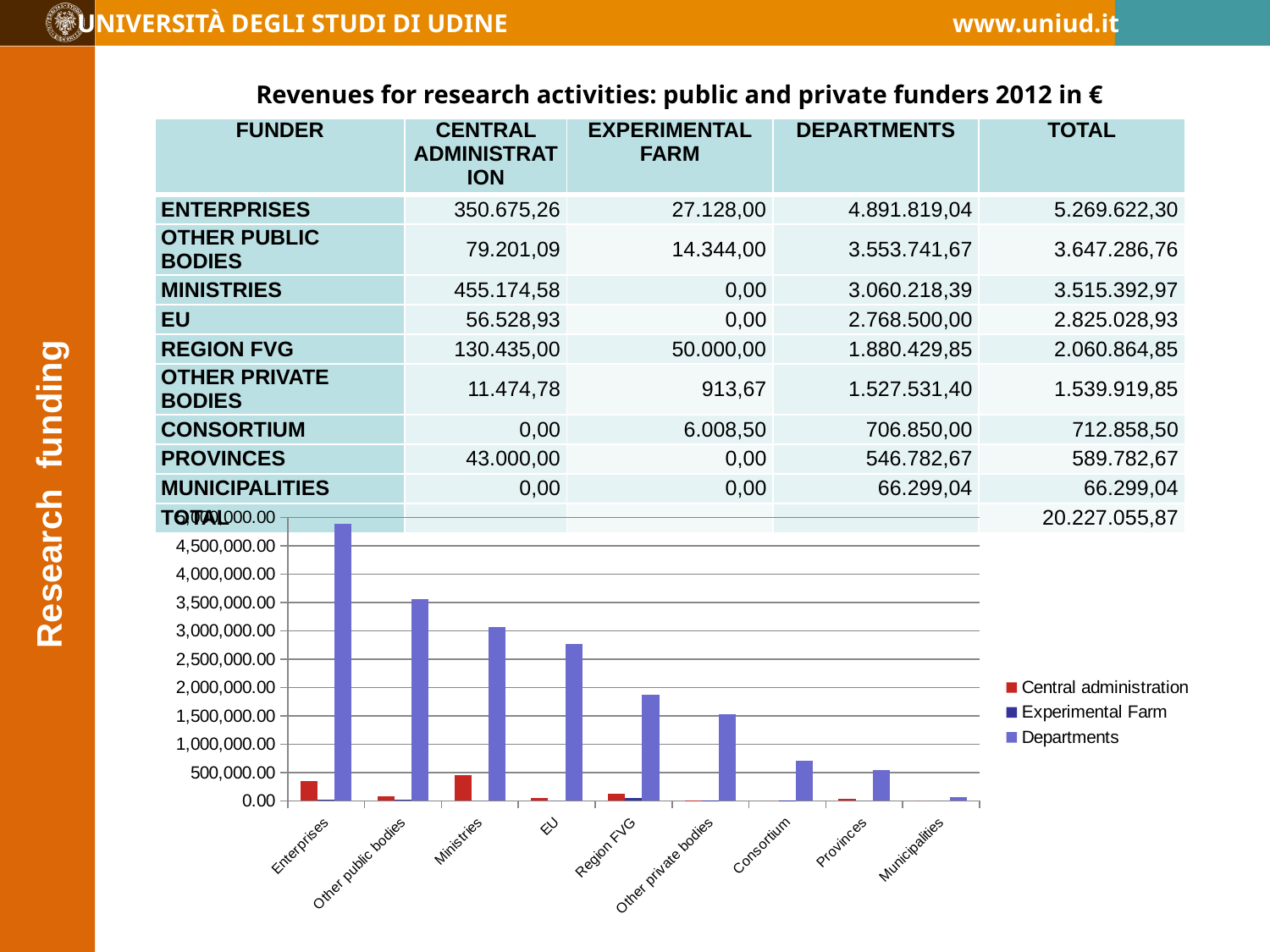
What kind of chart is shown on the slide? bar chart Which is larger, the Central administration value for Ministries or for Enterprises? Ministries Which is larger, the Departments value for EU or for Region FVG? EU Is the Departments value for Enterprises greater or less than 4,500,000.00? greater How many funder categories are plotted along the x axis of the chart? 9 Which funder has the lowest Departments value in the chart? Municipalities Which funder has the highest Departments value in the chart? Enterprises Is the Departments value for Ministries greater or less than 3,500,000.00? less How many series does the chart legend list? 3 Do the Departments bars rise or fall moving from left to right along the x axis? fall Which series is shown in red in the chart legend? Central administration Is the Departments value for Consortium greater or less than 500,000.00? greater